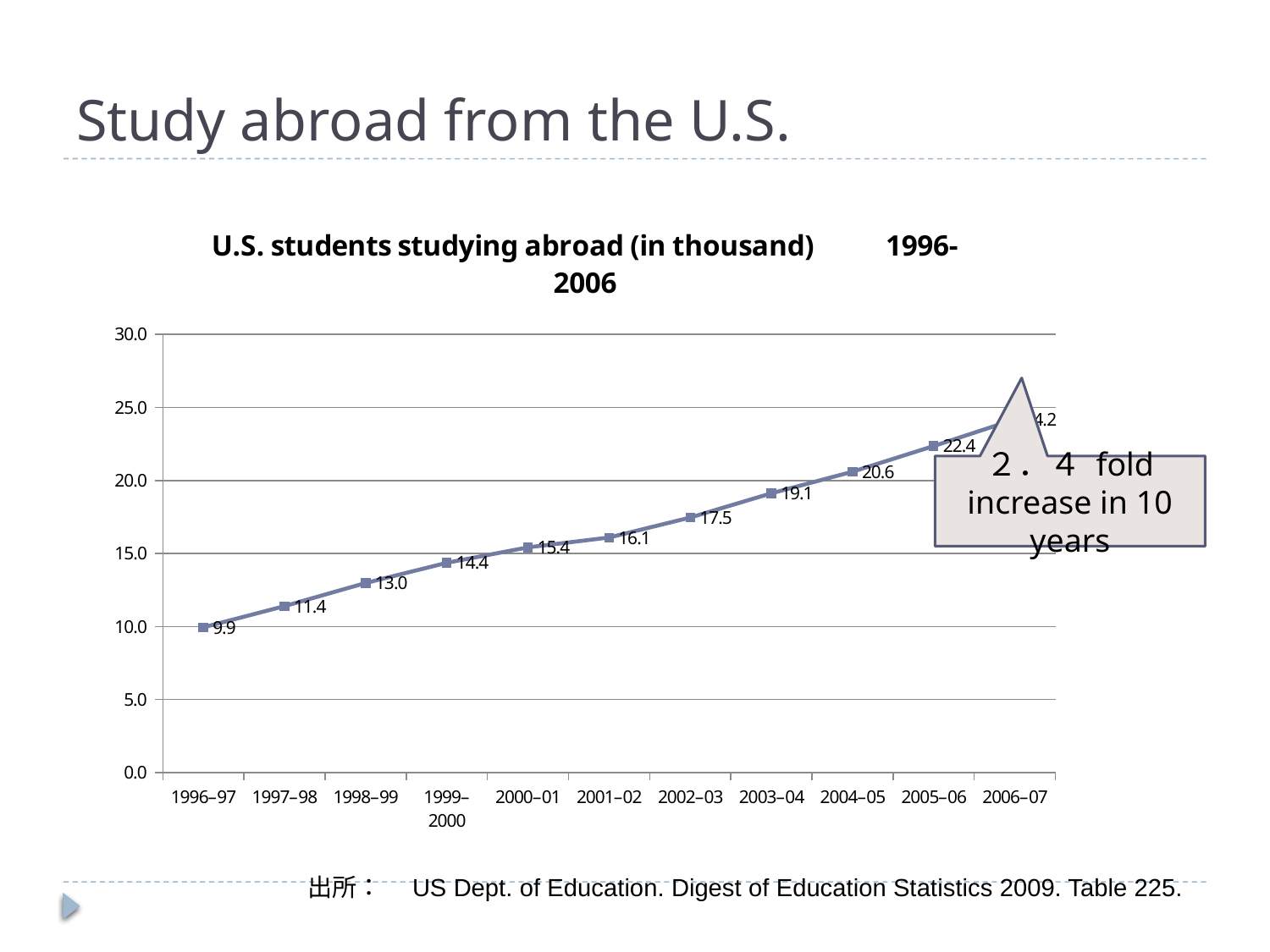
What is the difference between the values for 2003–04 and 2002–03? 1.6 Is the value for 2006–07 greater or less than 20.0? greater What is the value for 2001–02? 16.1 What is the value for 1996–97? 9.9 What is the difference between the values for 2005–06 and 1996–97? 12.5 Which is larger, the value for 2004–05 or the value for 2000–01? 2004–05 What is the value for 1999–2000? 14.4 What kind of chart is shown? line chart Which year has the highest value? 2006–07 How many years are plotted on the x axis? 11 What is the value for 2005–06? 22.4 Which year has the lowest value? 1996–97